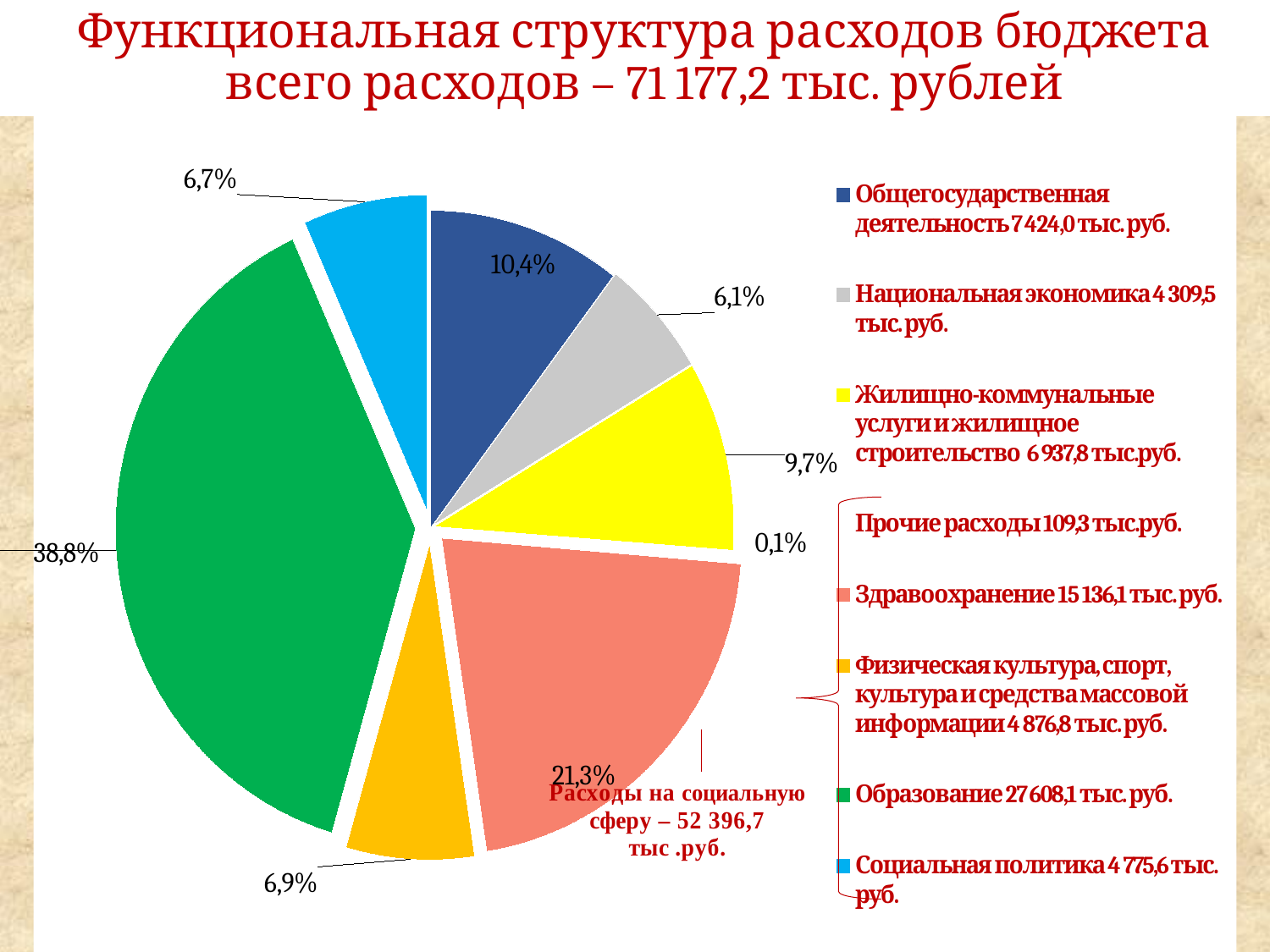
Which category has the smallest slice of the pie? Прочие расходы What kind of chart is shown on the slide? pie chart Which slice is larger: Национальная экономика or Социальная политика? Социальная политика What percentage is shown for Общегосударственная деятельность? 10,4% What share of the pie does Образование (education) take? 38,8% According to the legend, what is the amount for Здравоохранение? 15 136,1 тыс. руб. What share of the pie does Здравоохранение (healthcare) take? 21,3% How many slices does the pie chart have? 8 What is the difference in percentage points between the Образование slice and the Здравоохранение slice? 17,5 What total expenditure amount is stated in the chart title? 71 177,2 тыс. рублей What percentage is shown for Жилищно-коммунальные услуги и жилищное строительство? 9,7% Which category has the largest slice of the pie? Образование